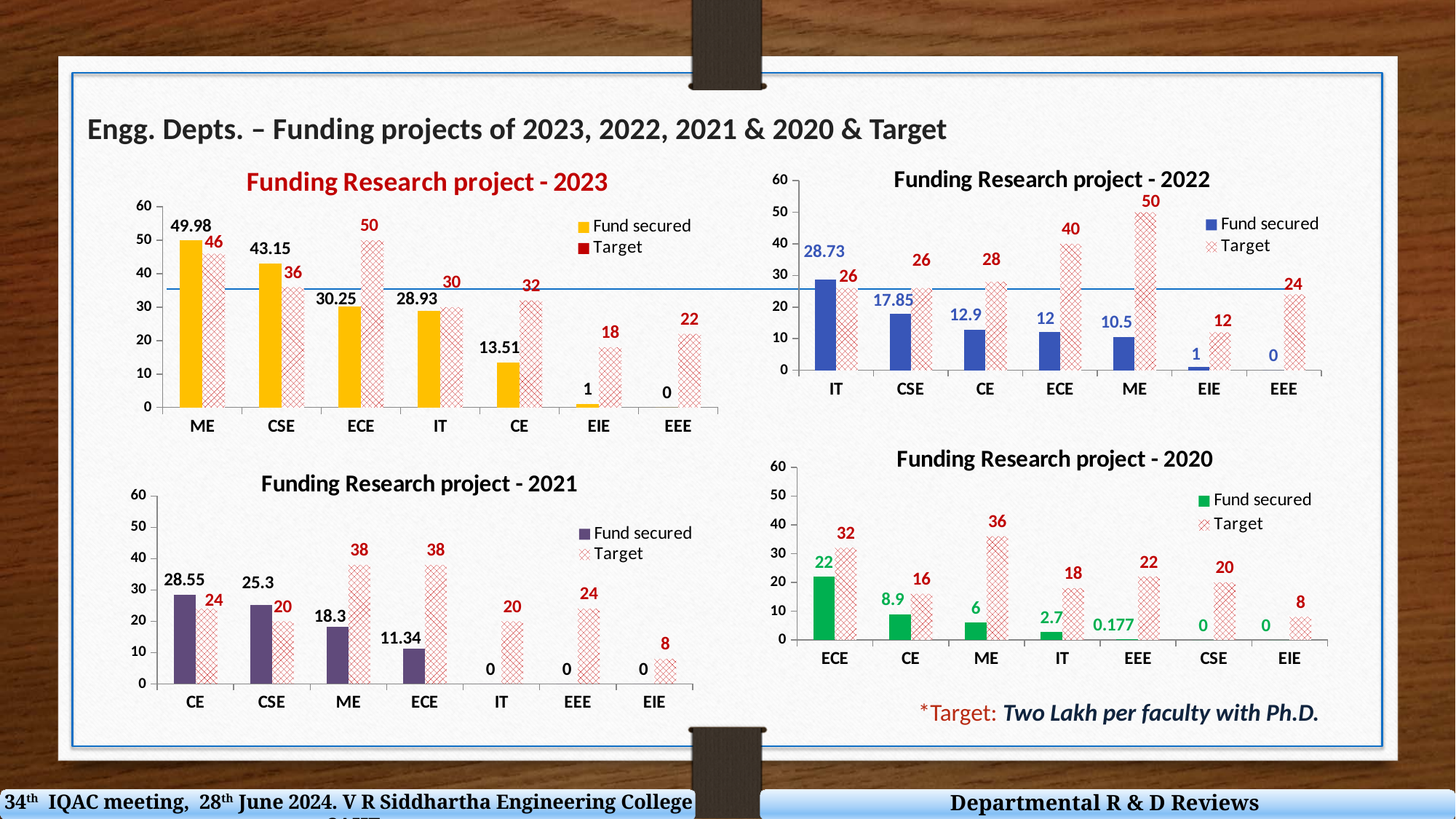
In the 'Funding Research project - 2021' chart, how many departments are shown on the x axis? 7 In the 'Funding Research project - 2021' chart, what is the Target value for ME? 38 In the 'Funding Research project - 2022' chart, which department has the lowest Fund secured value? EEE In the 'Funding Research project - 2022' chart, what is the Fund secured value for CSE? 17.85 In the 'Funding Research project - 2020' chart, which department has the highest Fund secured value? ECE In the 'Funding Research project - 2022' chart, is the Fund secured value for IT larger or smaller than its Target value? larger In the 'Funding Research project - 2020' chart, what is the Fund secured value for EEE? 0.177 How many series does the legend of the 'Funding Research project - 2020' chart list? 2 In the 'Funding Research project - 2021' chart, what is the difference between the Fund secured values for CE and CSE? 3.25 In the 'Funding Research project - 2023' chart, what is the difference between the Target and Fund secured values for CE? 18.49 In the 'Funding Research project - 2023' chart, what is the Fund secured value for ME? 49.98 In the 'Funding Research project - 2023' chart, which department has the highest Target value? ECE